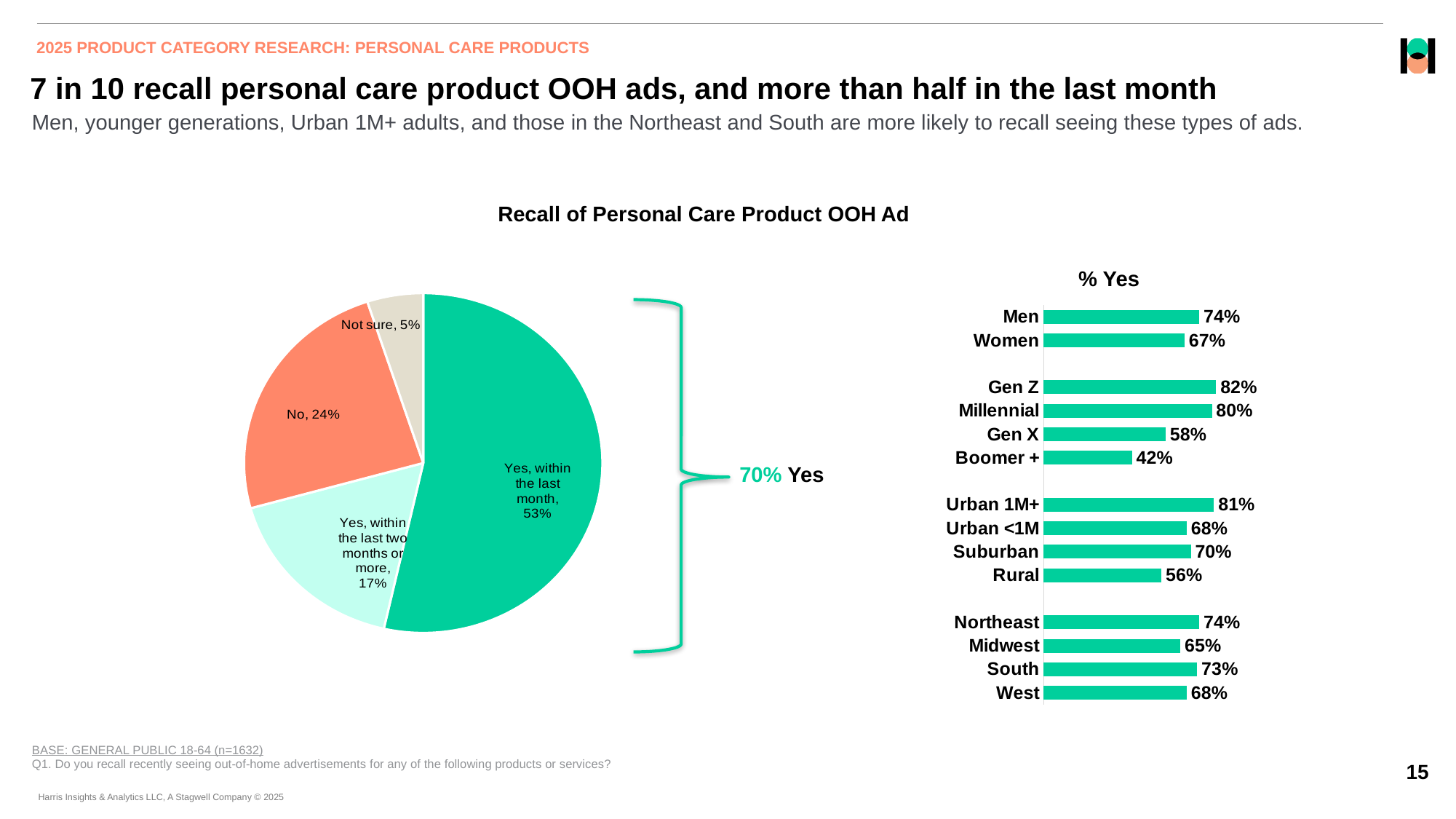
In the '% Yes' bar chart on the right, what is the value for Gen X? 58% In the pie chart on the left, which response has the smallest slice? Not sure In the pie chart on the left, what is the combined share of the two 'Yes' slices? 70% In the pie chart on the left, what share of respondents answered 'No'? 24% In the '% Yes' bar chart on the right, which group has the lowest value? Boomer + In the '% Yes' bar chart on the right, what is the difference between Men and Women? 7% In the '% Yes' bar chart on the right, which group has the highest value? Gen Z In the pie chart on the left, how many slices are there? 4 In the '% Yes' bar chart on the right, what is the value for Urban 1M+? 81% In the pie chart on the left, what share of respondents said 'Yes, within the last month'? 53% In the '% Yes' bar chart on the right, which is larger, Northeast or Midwest? Northeast What type of chart is the '% Yes' chart on the right? Bar chart